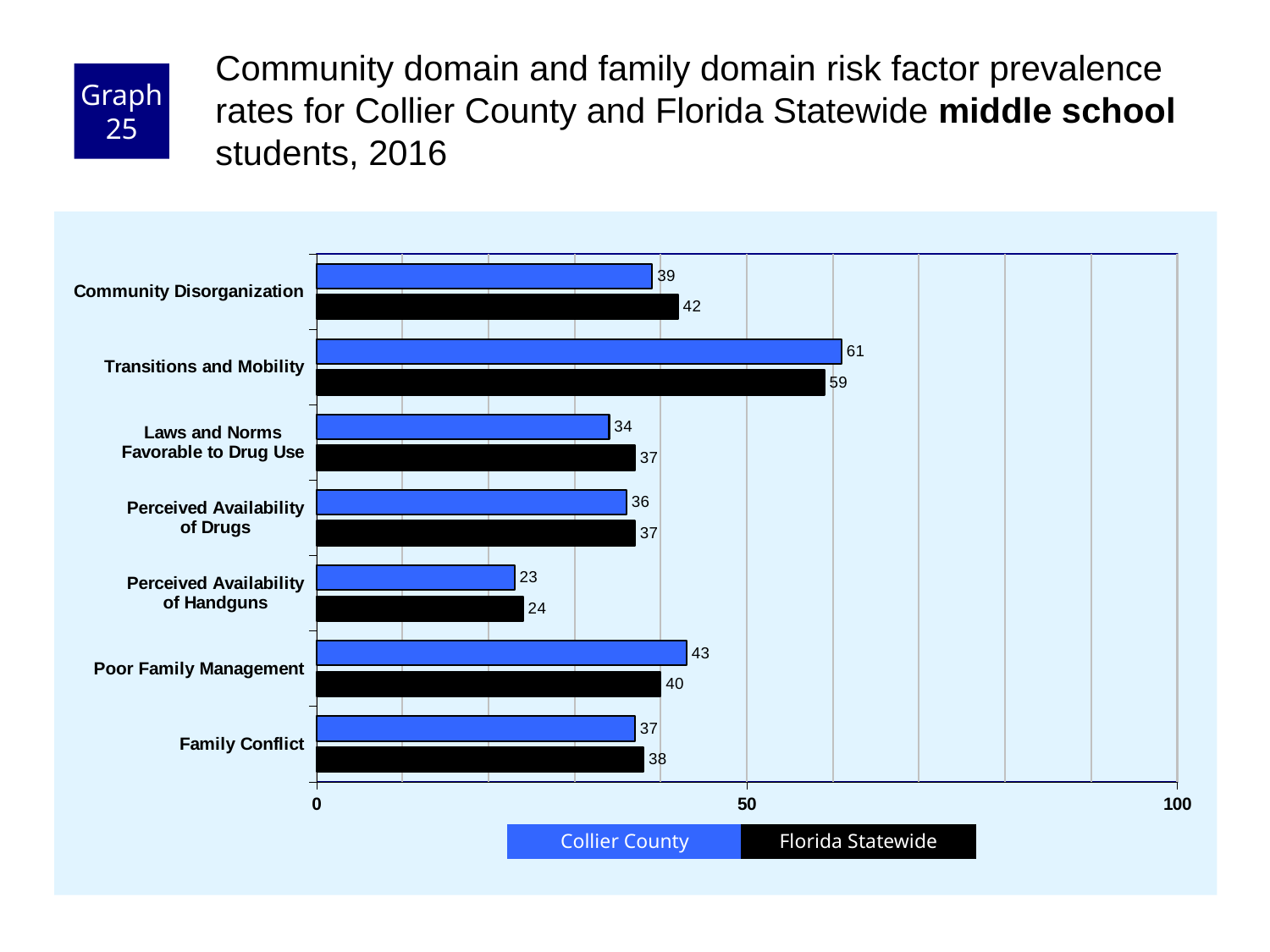
Which risk factor has the highest Collier County value? Transitions and Mobility How many risk factor categories are shown on the chart? 7 Which colour represents Florida Statewide in the chart? Black For Laws and Norms Favorable to Drug Use, which is larger: the Collier County value or the Florida Statewide value? Florida Statewide What kind of chart is shown on the slide? Bar chart Which risk factor has the lowest Florida Statewide value? Perceived Availability of Handguns What is the Florida Statewide value for Perceived Availability of Handguns? 24 How many series does the legend list? 2 What is the Collier County value for Transitions and Mobility? 61 Is the Florida Statewide value for Transitions and Mobility greater or less than 50? greater What is the difference between the Florida Statewide and Collier County values for Community Disorganization? 3 What is the Collier County value for Poor Family Management? 43